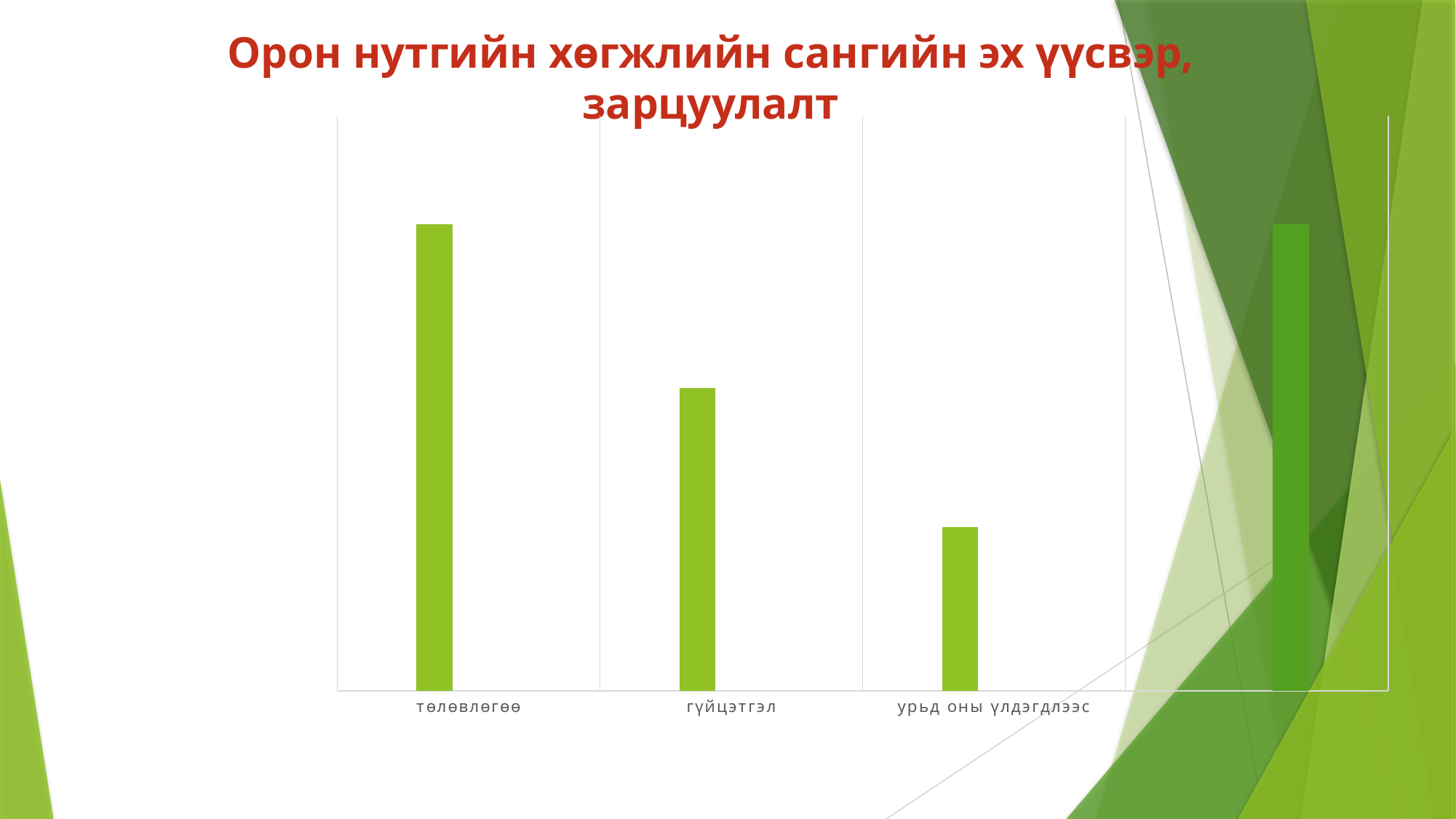
Which is larger, the bar for төлөвлөгөө or the bar for гүйцэтгэл? төлөвлөгөө Which is larger, the bar for төлөвлөгөө or the bar for урьд оны үлдэгдлээс? төлөвлөгөө Which category has the lowest bar in the chart? урьд оны үлдэгдлээс Which is larger, the bar for гүйцэтгэл or the bar for урьд оны үлдэгдлээс? гүйцэтгэл What is the title of the slide containing the chart? Орон нутгийн хөгжлийн сангийн эх үүсвэр, зарцуулалт Do the bars rise or fall going from төлөвлөгөө to гүйцэтгэл to урьд оны үлдэгдлээс? fall What is the label of the first category on the x axis? төлөвлөгөө What kind of chart is shown on the slide? bar chart What colour are the bars in the chart? green What is the label of the second category on the x axis? гүйцэтгэл Of the three labelled categories төлөвлөгөө, гүйцэтгэл and урьд оны үлдэгдлээс, which has the highest bar? төлөвлөгөө